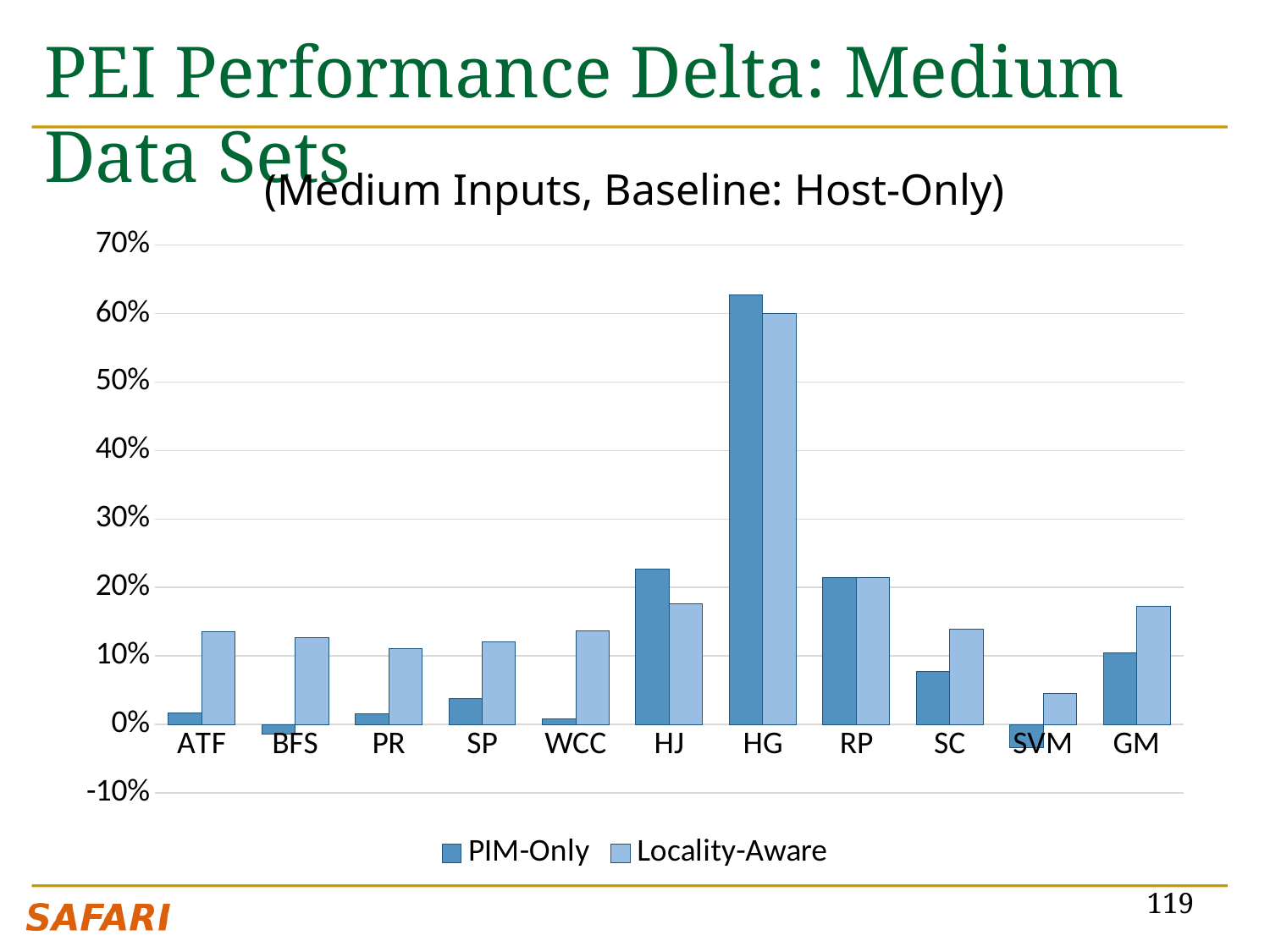
Which category has the highest PIM-Only value? HG Is the Locality-Aware value for GM greater or less than 20%? less Is the PIM-Only value for HG greater or less than 60%? greater How many categories are shown along the x axis of the chart? 11 Which category has the lowest Locality-Aware value? SVM For ATF, which is larger: the PIM-Only value or the Locality-Aware value? Locality-Aware Which category has the highest Locality-Aware value? HG Is the PIM-Only value for SC greater or less than 10%? less What kind of chart is shown on the slide? bar chart What are the two series named in the chart's legend? PIM-Only and Locality-Aware How many series does the chart's legend list? 2